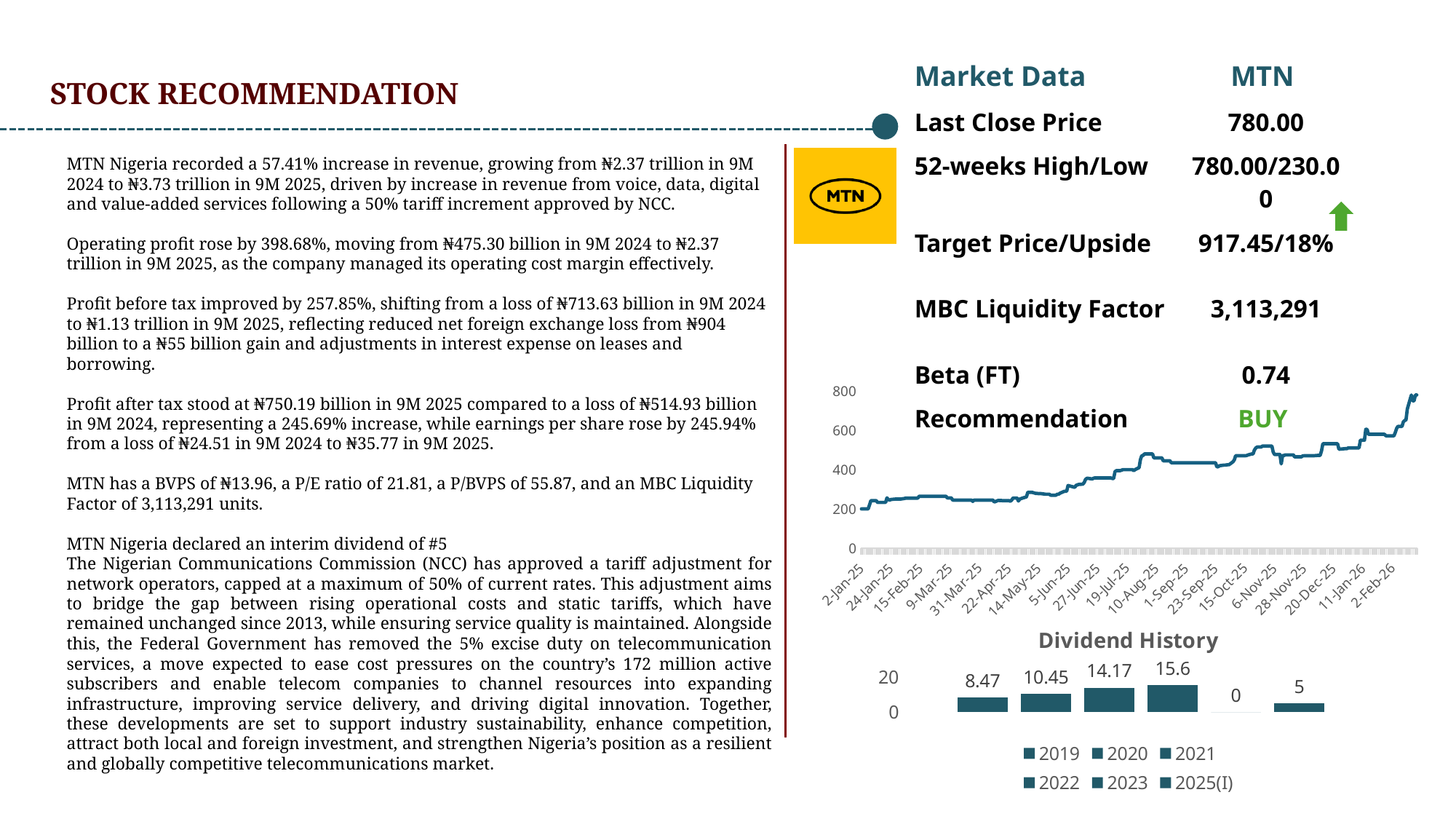
In the Dividend History chart, which is larger, the 2020 dividend or the 2019 dividend? 2020 In the share price line chart, is the value at 2-Jan-25 greater or less than 400? less What kind of chart is the Dividend History chart? Bar chart What kind of chart is the share price chart above the Dividend History chart? Line chart In the share price line chart, do values generally rise or fall from 2-Jan-25 to 2-Feb-26? Rise In the Dividend History chart, which year has the highest dividend? 2022 In the Dividend History chart, what is the difference between the 2022 and 2021 dividends? 1.43 How many entries does the legend of the Dividend History chart list? 6 In the Dividend History chart, what is the dividend value for 2019? 8.47 In the Dividend History chart, which year has the lowest dividend? 2023 In the Dividend History chart, what is the dividend value for 2022? 15.6 In the Dividend History chart, what is the dividend value for 2025(I)? 5